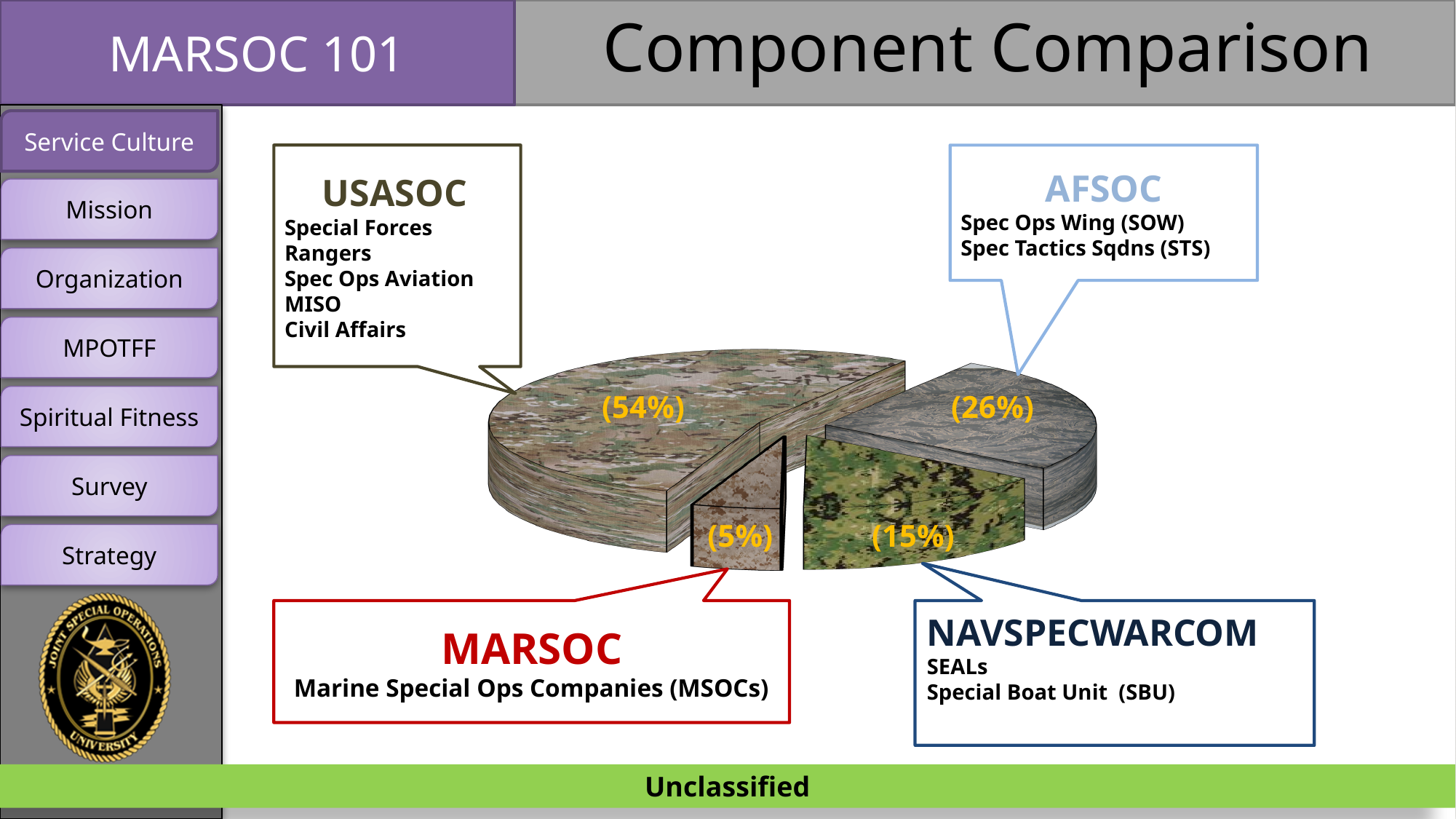
What is the difference in percentage points between the NAVSPECWARCOM slice and the MARSOC slice? 10 What kind of chart is shown on the slide? pie chart What share of the pie does AFSOC hold? 26% How many slices does the pie chart have? 4 Which component has the smallest slice of the pie? MARSOC Which component has the largest slice of the pie? USASOC Which slice is larger, NAVSPECWARCOM or MARSOC? NAVSPECWARCOM What share of the pie does NAVSPECWARCOM hold? 15% What is the title of the slide containing the pie chart? Component Comparison What share of the pie does USASOC hold? 54% What is the difference in percentage points between the USASOC slice and the AFSOC slice? 28 What share of the pie does MARSOC hold? 5%